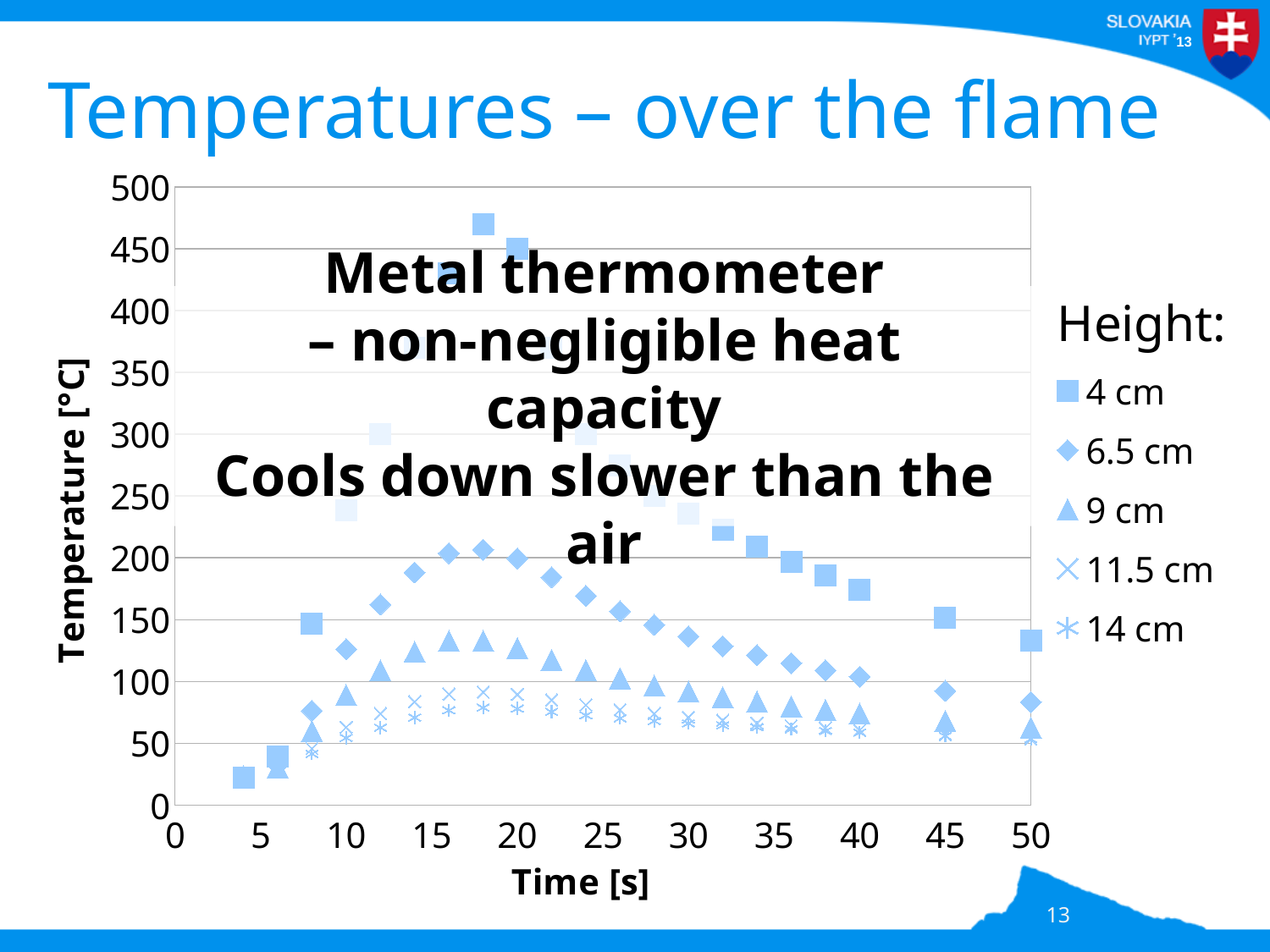
Is the peak temperature of the 4 cm series greater or less than 450? greater Is the temperature of the 4 cm series at 50 s greater or less than 150? less Does the temperature of the 4 cm series rise or fall between 18 s and 50 s? fall What kind of chart is shown on the slide? scatter chart Is the temperature of the 6.5 cm series at 16 s greater or less than 150? greater At 30 s, which series has the higher temperature, 4 cm or 6.5 cm? 4 cm Which height series stays at the lowest temperatures overall? 14 cm What is the title of the chart's y axis? Temperature [°C] How many series does the legend list? 5 What is the title of the chart's x axis? Time [s] Which height series reaches the highest temperature? 4 cm